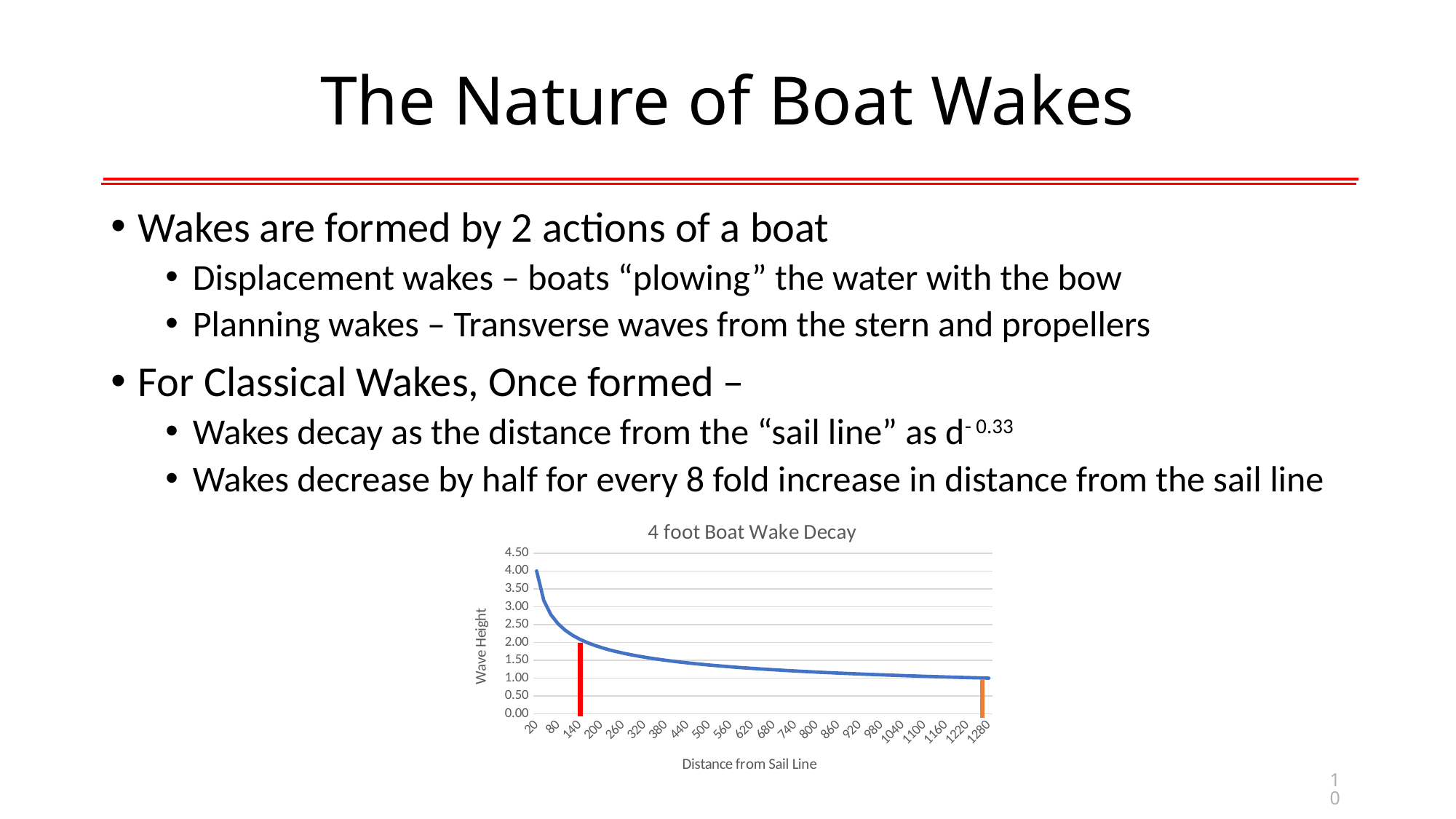
What is the title of the chart? 4 foot Boat Wake Decay Is the wave height at a distance of 620 greater or less than 2.00? less What is the label on the vertical axis of the chart? Wave Height At which distance from the sail line is the wave height highest? 20 Is the wave height at a distance of 20 greater or less than 3.50? greater What kind of chart is shown on the slide? line chart Which distance has the higher wave height, 20 or 1280? 20 At which distance from the sail line is the wave height lowest? 1280 Which distance has the higher wave height, 140 or 860? 140 Does the wave height rise or fall as the distance from the sail line increases? fall Is the wave height at a distance of 1280 greater or less than 1.50? less